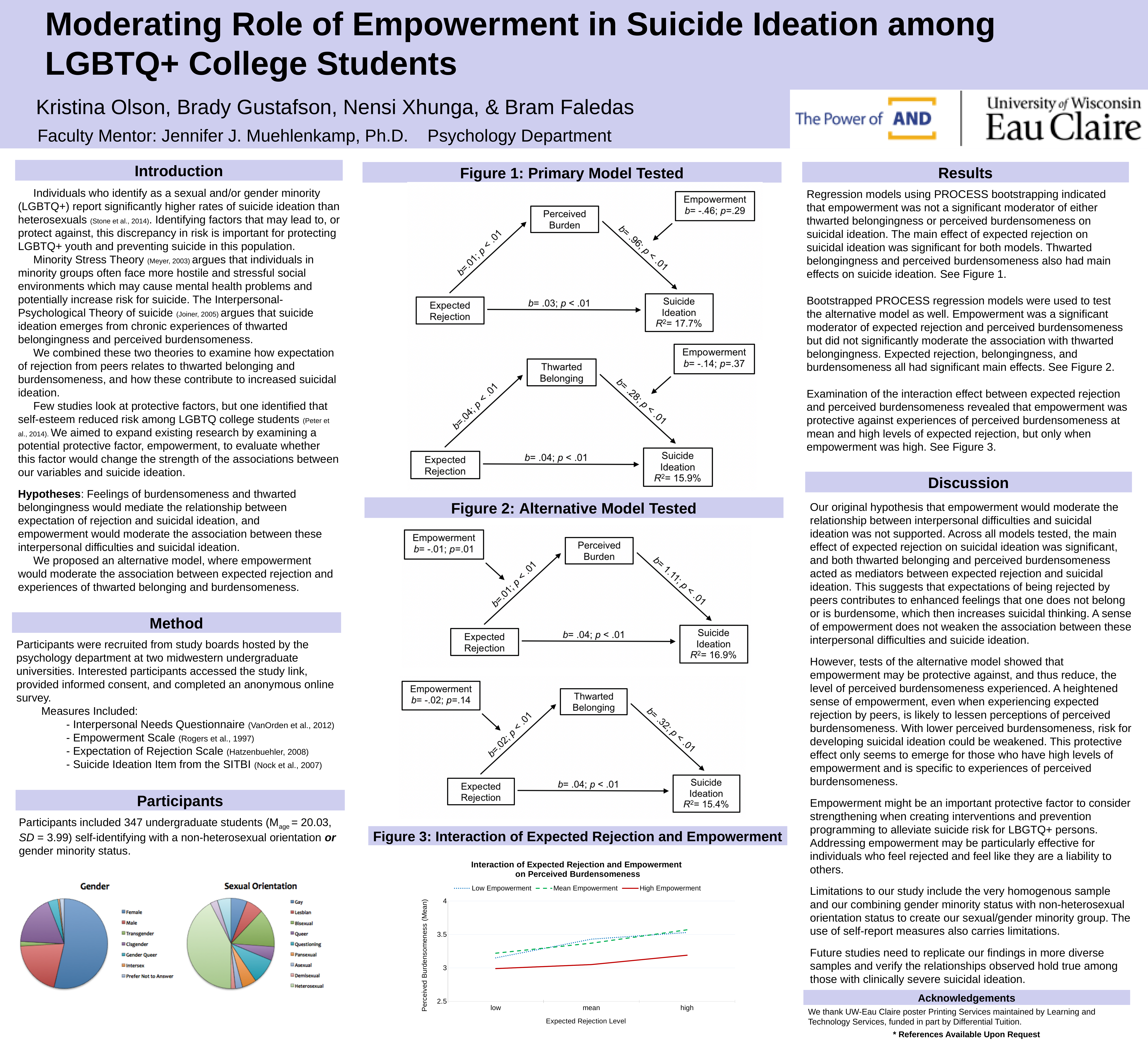
In the Figure 3 line chart, how many Expected Rejection Level categories are on the x axis? 3 In the Figure 3 line chart, which series has the lowest Perceived Burdensomeness values across all Expected Rejection Levels? High Empowerment How many categories does the legend of the Gender pie chart list? 7 What kind of chart is the Gender chart at the bottom left of the slide? pie chart In the Figure 3 line chart, do the Perceived Burdensomeness values for High Empowerment rise or fall as Expected Rejection Level goes from low to high? rise How many categories does the legend of the Sexual Orientation pie chart list? 9 How many series does the legend of the Figure 3 line chart list? 3 In the Figure 3 line chart, is the value for High Empowerment at the high Expected Rejection Level greater or less than 3.5? less Which category has the largest slice in the Gender pie chart? Female What kind of chart is the Figure 3 chart 'Interaction of Expected Rejection and Empowerment on Perceived Burdensomeness'? line chart In the Figure 3 line chart, at the high Expected Rejection Level, which is larger: the Low Empowerment value or the High Empowerment value? Low Empowerment